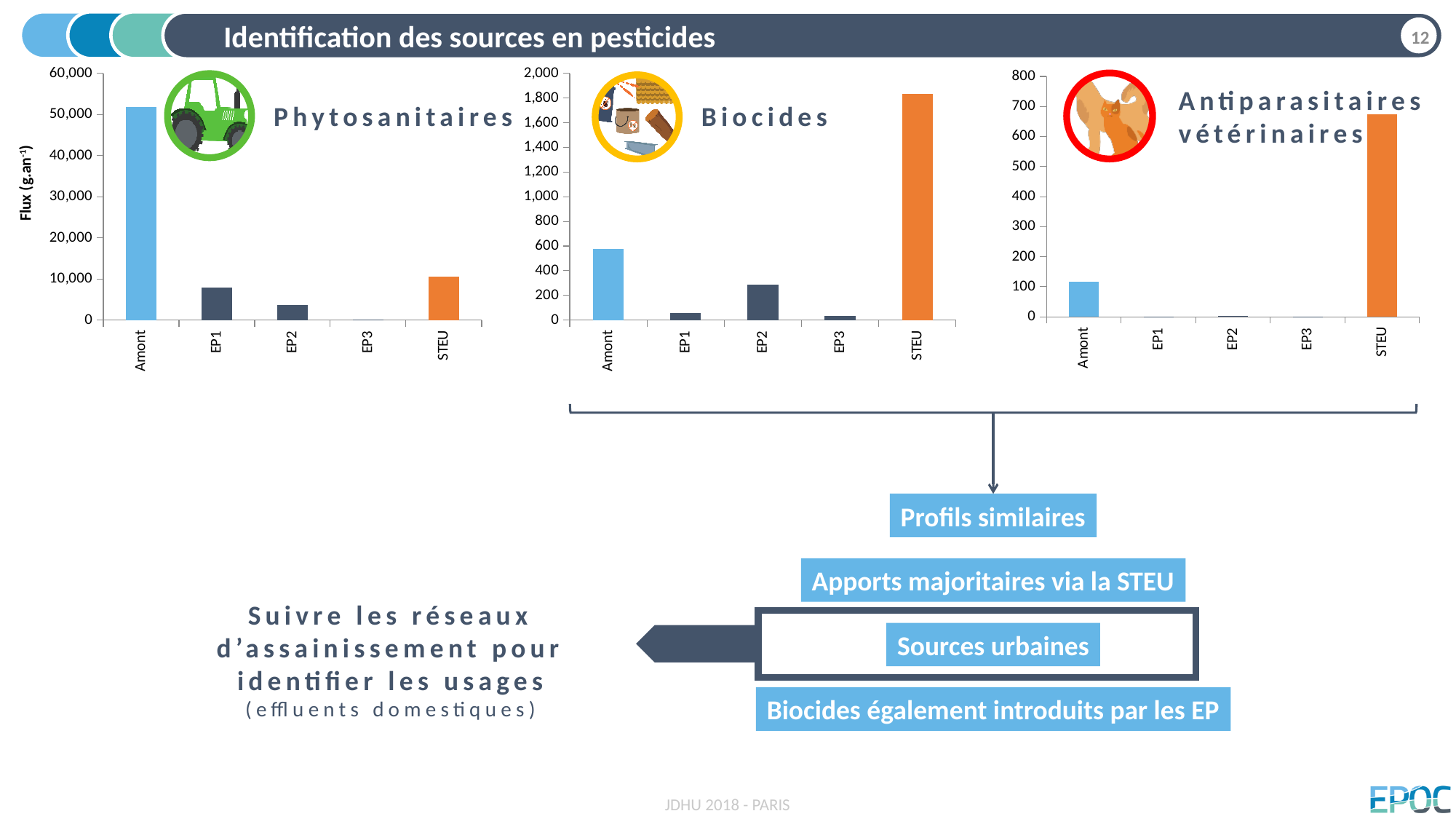
How many categories are shown on the x axis of the Biocides chart? 5 In the Phytosanitaires chart, is the value for EP1 greater or less than 10,000? less In the Phytosanitaires chart, which category has the highest value? Amont In the Biocides chart, is the value for STEU greater or less than 1,600? greater In the Phytosanitaires chart, is the value for Amont greater or less than 50,000? greater In the Antiparasitaires vétérinaires chart, which category has the highest value? STEU In the Biocides chart, which is larger, the value for EP2 or the value for EP1? EP2 In the Biocides chart, which category has the highest value? STEU What kind of chart is the Phytosanitaires chart? bar chart In the Biocides chart, which category has the lowest value? EP3